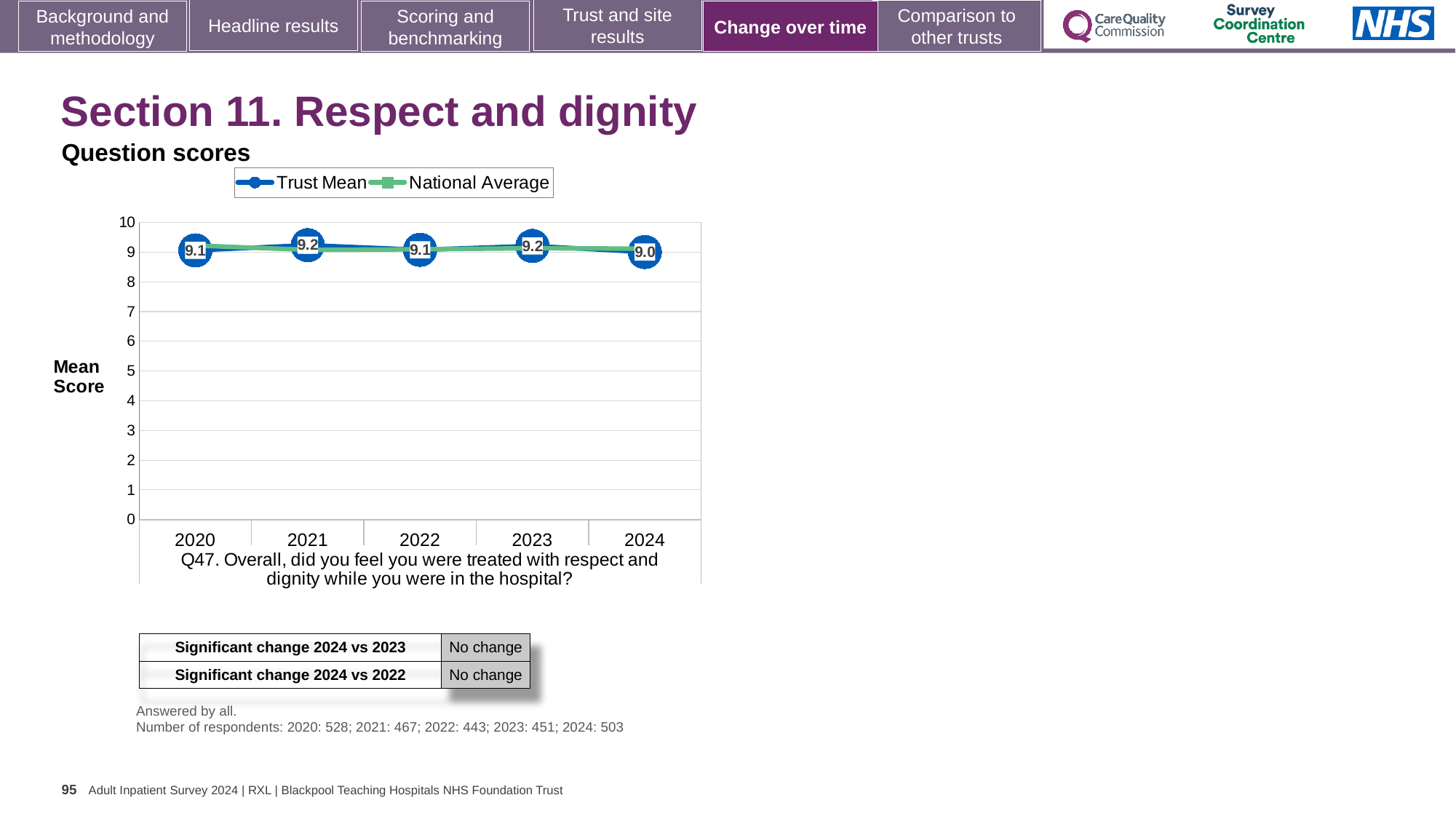
What is the label of the y axis? Mean Score What is the difference between the Trust Mean scores for 2021 and 2024? 0.2 How many series does the legend list? 2 Which is larger, the Trust Mean score for 2023 or for 2024? 2023 What is the Trust Mean score for 2020? 9.1 How many years are shown on the x axis? 5 What kind of chart is shown? line chart Is the National Average value for 2022 greater or less than 8? greater What is the Trust Mean score for 2024? 9.0 What is the Trust Mean score for 2021? 9.2 In which year is the Trust Mean score lowest? 2024 Does the Trust Mean rise or fall from 2023 to 2024? fall